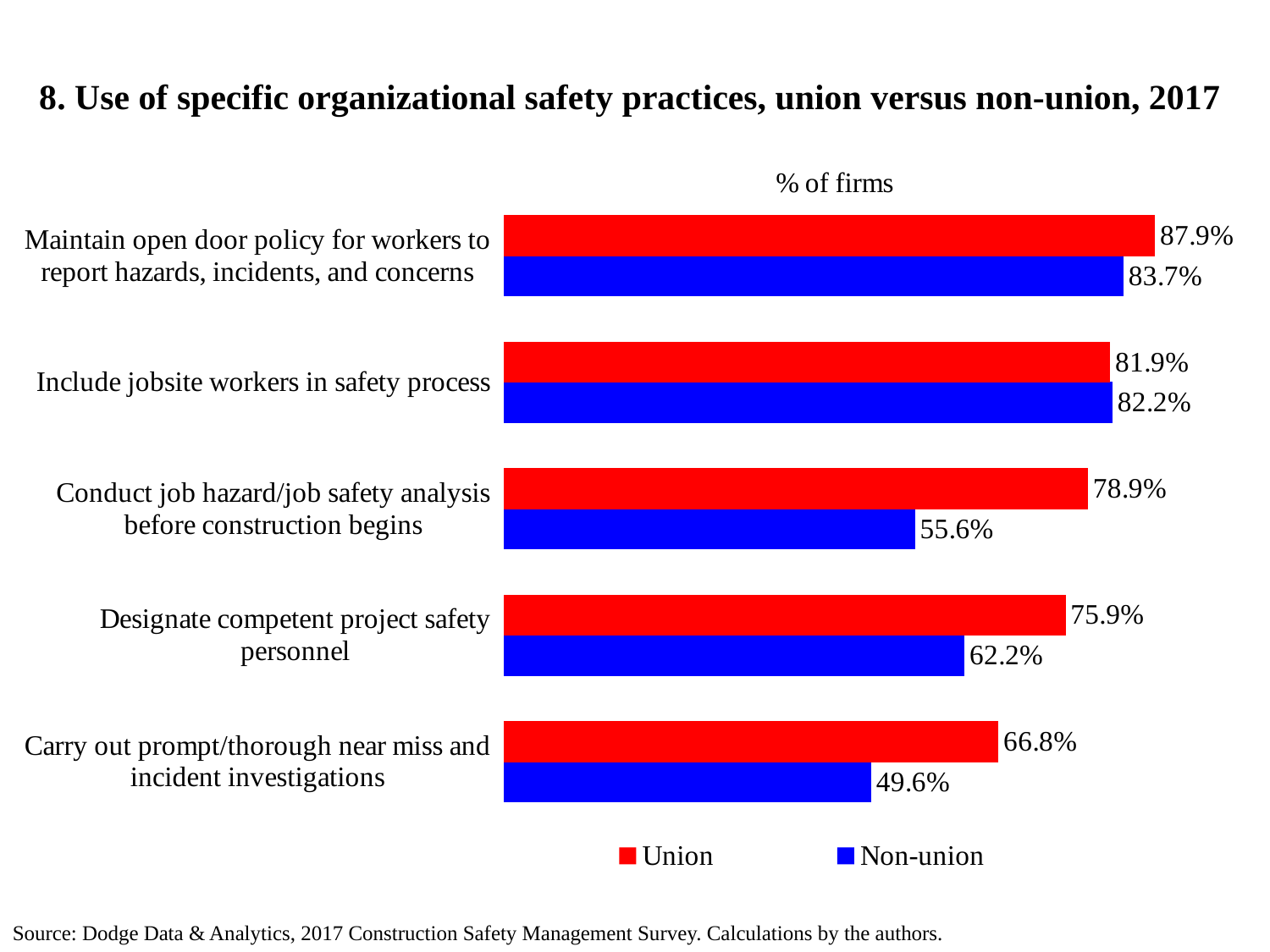
How many series does the legend list? 2 What percentage of union firms maintain an open door policy for workers to report hazards, incidents, and concerns? 87.9% What percentage of non-union firms carry out prompt/thorough near miss and incident investigations? 49.6% How many safety practices are shown in the chart? 5 What is the difference between the union and non-union percentages for designating competent project safety personnel? 13.7% Which safety practice has the lowest percentage of non-union firms? Carry out prompt/thorough near miss and incident investigations What is the difference between the union and non-union percentages for conducting job hazard/job safety analysis before construction begins? 23.3% For including jobsite workers in the safety process, which group has the higher percentage, union or non-union? Non-union What percentage of non-union firms conduct job hazard/job safety analysis before construction begins? 55.6% What type of chart is shown on the slide? Bar chart Which colour represents non-union firms in the chart? Blue Which safety practice has the highest percentage of union firms? Maintain open door policy for workers to report hazards, incidents, and concerns